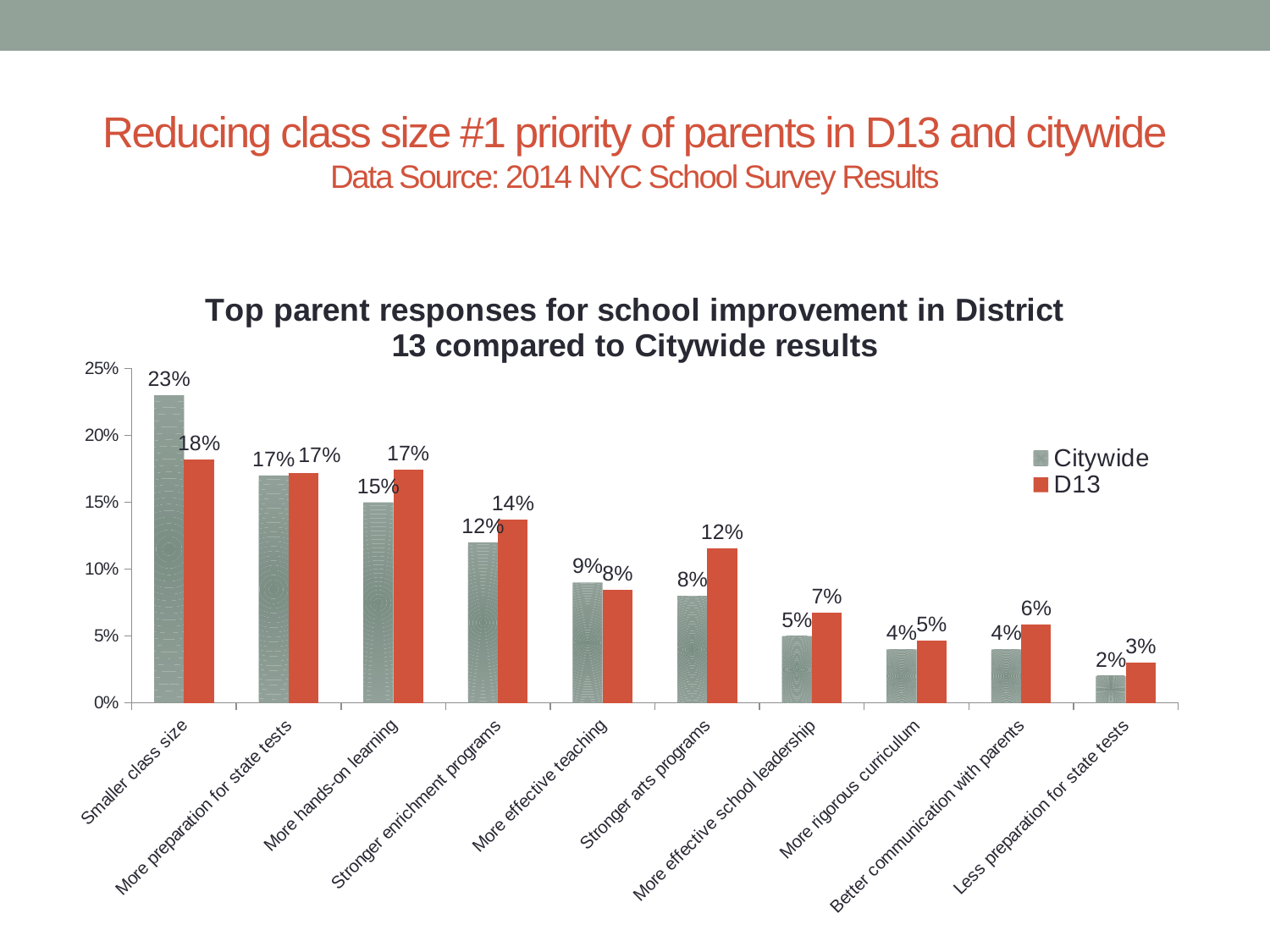
What kind of chart is shown on the slide? Bar chart How many series does the legend list? 2 What is the Citywide value for Smaller class size? 23% How many categories are shown on the x axis? 10 What is the D13 value for Better communication with parents? 6% What is the difference between the Citywide and D13 values for Smaller class size? 5% What is the D13 value for Stronger arts programs? 12% Which category has the highest Citywide value? Smaller class size Which is larger for Stronger arts programs, the Citywide value or the D13 value? D13 Which category has the lowest D13 value? Less preparation for state tests What colour are the D13 bars? Red Do the Citywide values generally rise or fall from left to right along the x axis? Fall